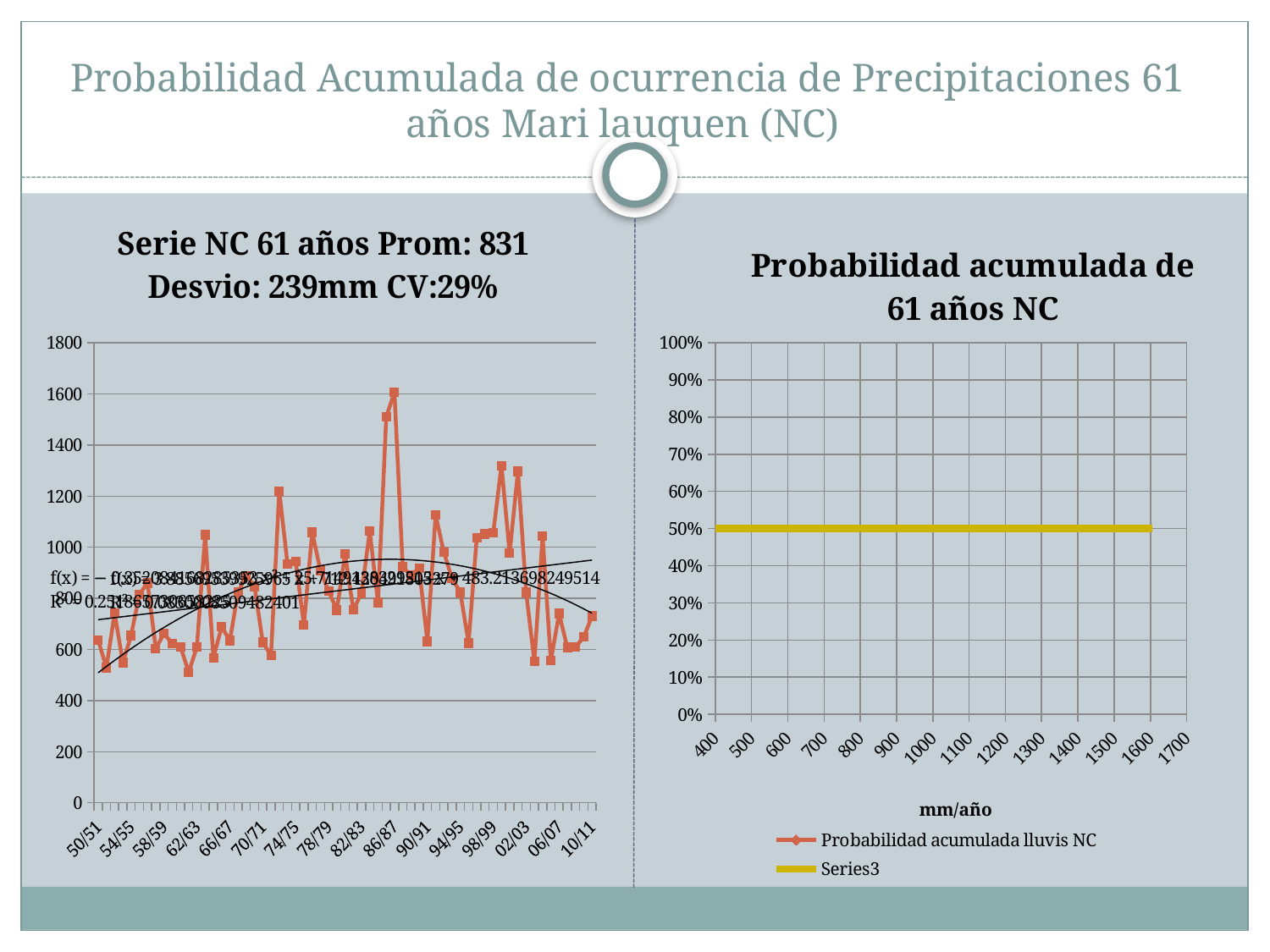
In the left chart "Serie NC 61 años", what is the first label on the x axis? 50/51 In the right chart "Probabilidad acumulada de 61 años NC", how many series does the legend list? 2 What kind of chart is the left chart titled "Serie NC 61 años Prom: 831 Desvio: 239mm CV:29%"? line chart In the right chart "Probabilidad acumulada de 61 años NC", what is the x-axis title? mm/año In the left chart "Serie NC 61 años", is the value for 50/51 greater or less than 800? less In the left chart "Serie NC 61 años", is the value for 10/11 greater or less than 1000? less In the right chart "Probabilidad acumulada de 61 años NC", how many tick labels are shown on the x axis? 14 What kind of chart is the right chart titled "Probabilidad acumulada de 61 años NC"? line chart In the left chart "Serie NC 61 años", what is the maximum value shown on the y axis? 1800 In the left chart "Serie NC 61 años", is the value at the highest peak (around 86/87) greater or less than 1400? greater In the right chart "Probabilidad acumulada de 61 años NC", what is the highest value shown on the y axis? 100% In the right chart "Probabilidad acumulada de 61 años NC", at what level does the yellow Series3 line sit? 50%